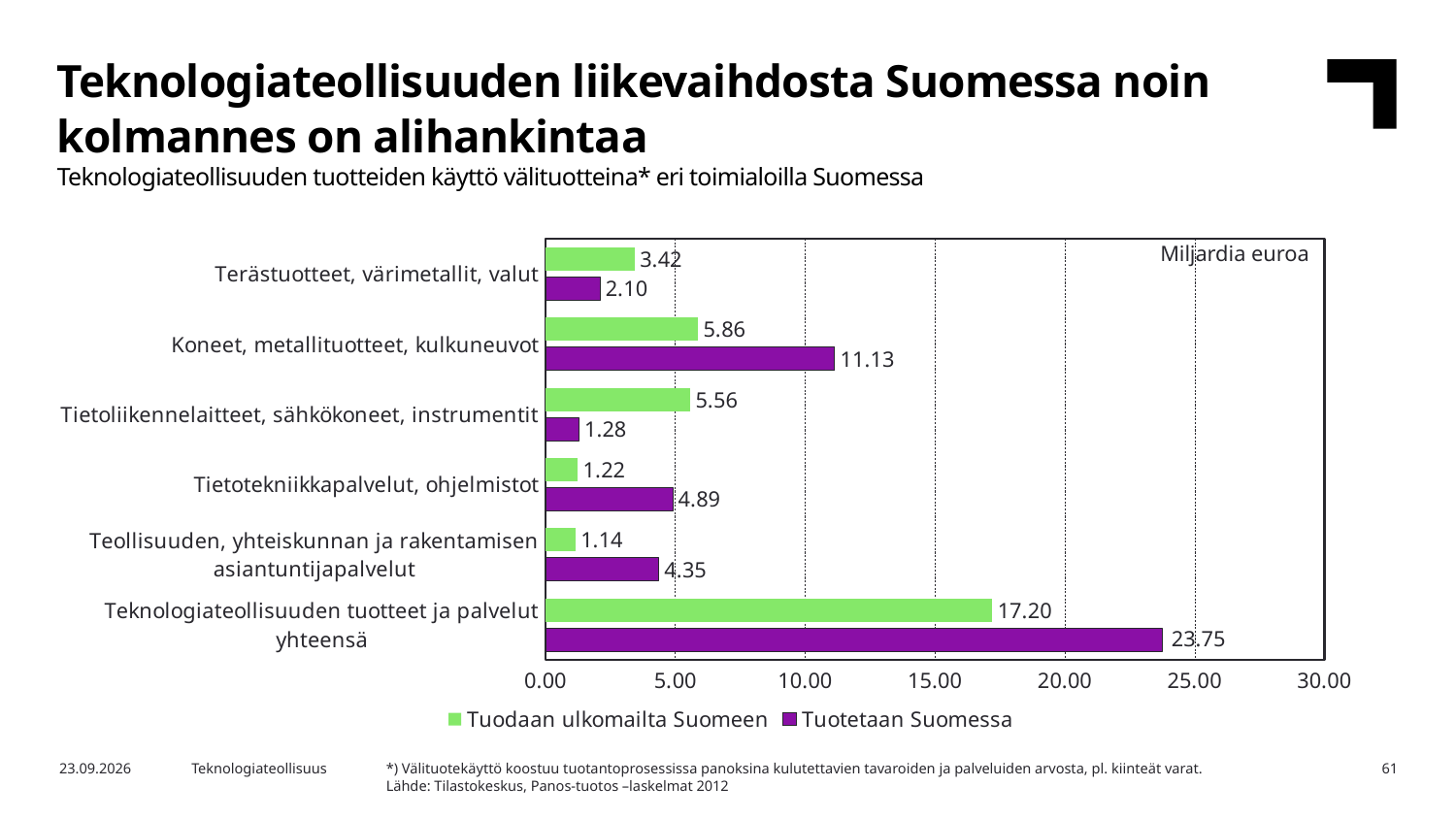
How many series does the legend list? 2 What kind of chart is shown on the slide? Bar chart For Tietotekniikkapalvelut, ohjelmistot, which is larger: "Tuodaan ulkomailta Suomeen" or "Tuotetaan Suomessa"? Tuotetaan Suomessa Which category has the lowest "Tuodaan ulkomailta Suomeen" value? Teollisuuden, yhteiskunnan ja rakentamisen asiantuntijapalvelut What is the difference between "Tuotetaan Suomessa" and "Tuodaan ulkomailta Suomeen" for Teknologiateollisuuden tuotteet ja palvelut yhteensä? 6.55 What is the value of "Tuotetaan Suomessa" for Terästuotteet, värimetallit, valut? 2.10 How many categories are shown on the chart? 6 What is the value of "Tuodaan ulkomailta Suomeen" for Tietoliikennelaitteet, sähkökoneet, instrumentit? 5.56 Excluding the total row (yhteensä), which category has the highest "Tuotetaan Suomessa" value? Koneet, metallituotteet, kulkuneuvot What unit is indicated in the top right corner of the chart? Miljardia euroa What is the value of "Tuotetaan Suomessa" for Koneet, metallituotteet, kulkuneuvot? 11.13 Is the "Tuotetaan Suomessa" value for Teknologiateollisuuden tuotteet ja palvelut yhteensä greater or less than 20.00? greater